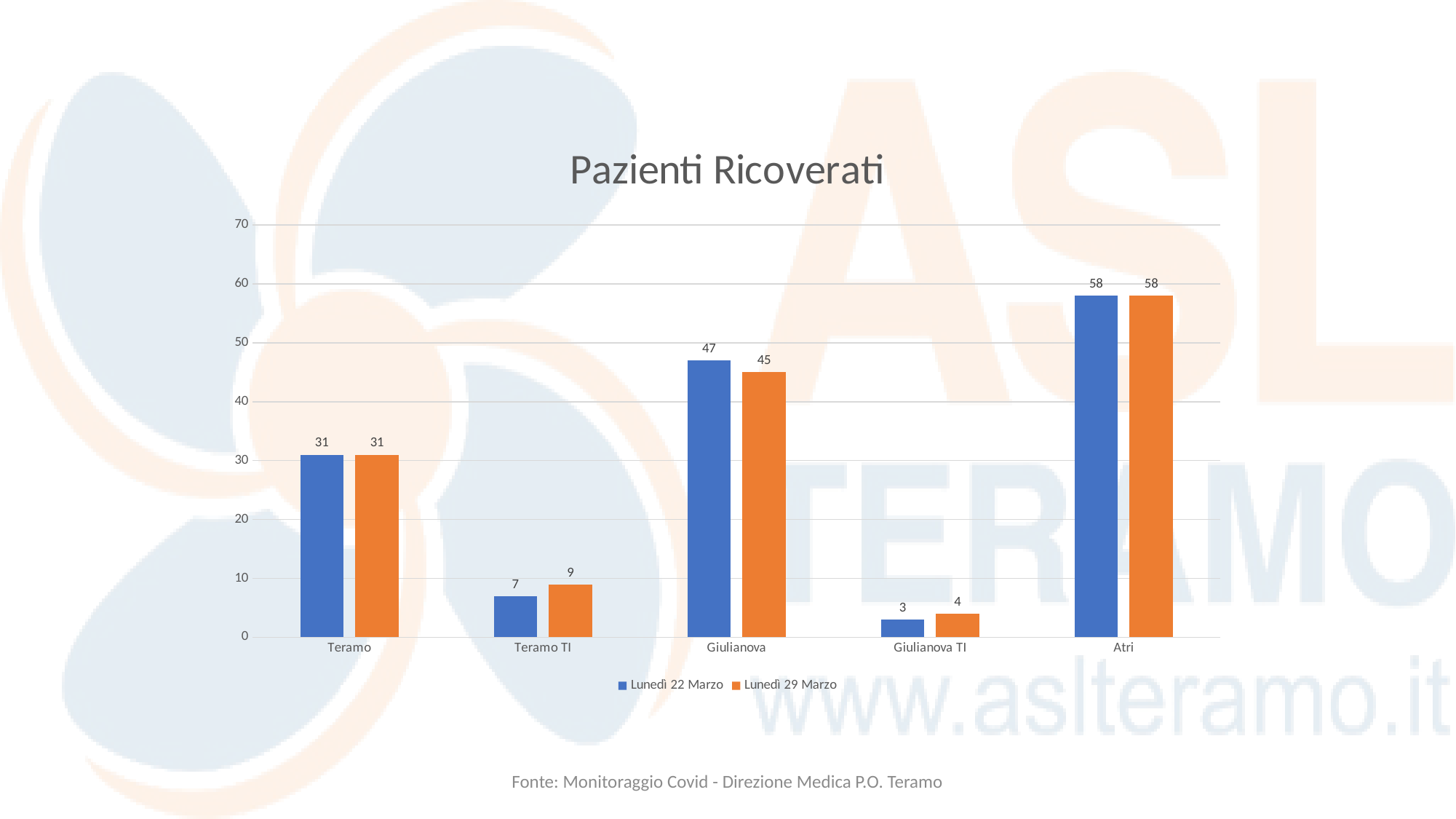
What kind of chart is shown on the slide? Bar chart How many series does the legend list? 2 Which category has the highest value in the Lunedì 22 Marzo series? Atri How many categories are shown on the x axis? 5 Which category has the lowest value in the Lunedì 29 Marzo series? Giulianova TI What is the title of the chart? Pazienti Ricoverati Is the value for Atri in the Lunedì 22 Marzo series greater or less than 50? greater What is the difference between the Lunedì 22 Marzo and Lunedì 29 Marzo values for Giulianova? 2 What is the value for Giulianova in the Lunedì 22 Marzo series? 47 What is the value for Teramo TI in the Lunedì 29 Marzo series? 9 What is the value for Atri in the Lunedì 29 Marzo series? 58 Which is larger for Teramo TI: the Lunedì 22 Marzo value or the Lunedì 29 Marzo value? Lunedì 29 Marzo